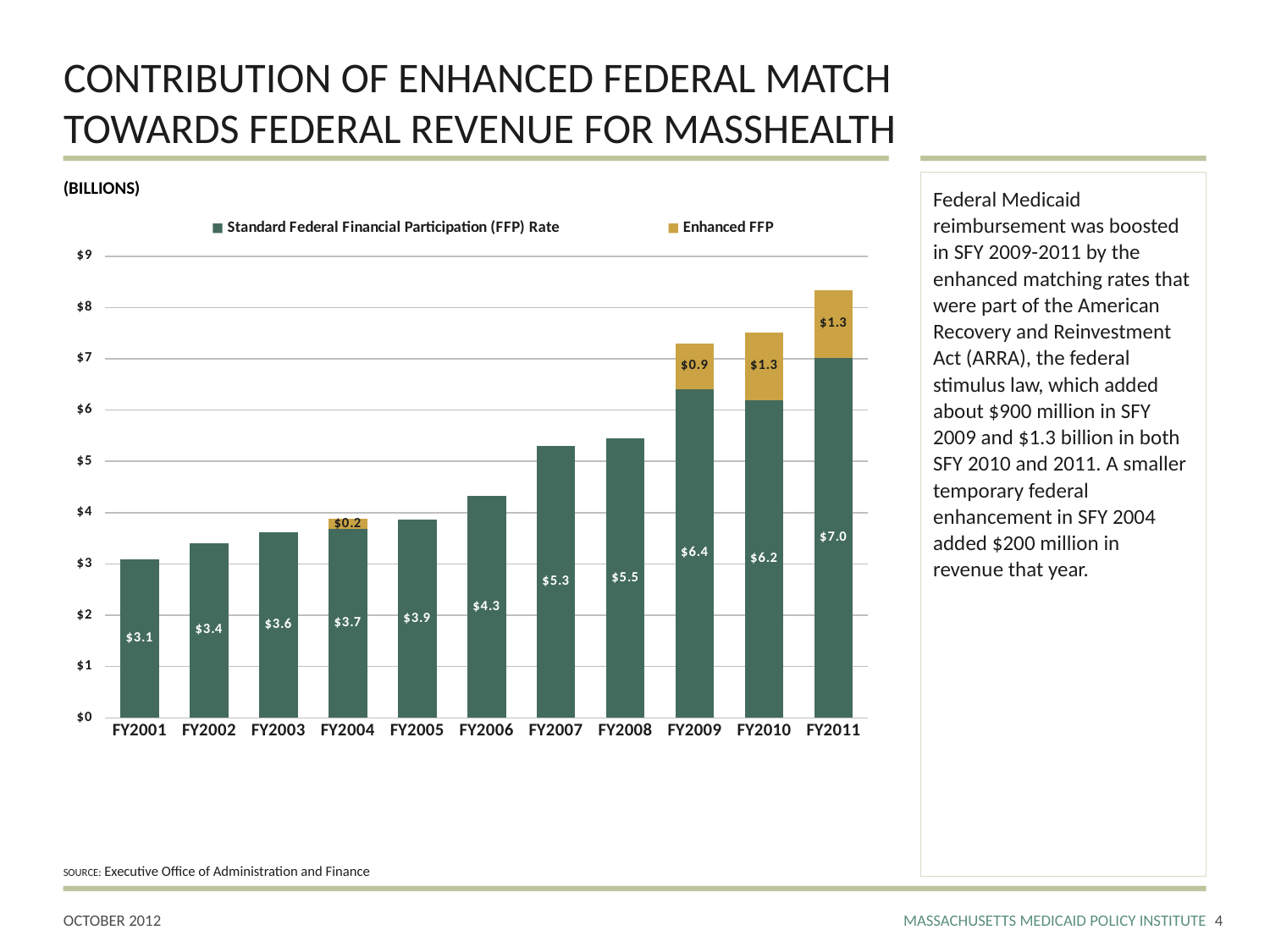
How many fiscal years are shown on the x axis? 11 What unit is indicated above the chart? Billions What kind of chart is shown on the slide? Stacked bar chart What is the total of the stacked bar for FY2011? $8.3 Which is larger, the Standard FFP Rate value for FY2006 or for FY2008? FY2008 Which fiscal year has the highest Standard Federal Financial Participation (FFP) Rate value? FY2011 What is the Enhanced FFP value for FY2009? $0.9 What is the Standard Federal Financial Participation (FFP) Rate value for FY2007? $5.3 What is the Standard Federal Financial Participation (FFP) Rate value for FY2001? $3.1 Which fiscal year has the lowest Standard Federal Financial Participation (FFP) Rate value? FY2001 What is the difference between the Standard FFP Rate values for FY2009 and FY2010? $0.2 How many series does the legend list? 2